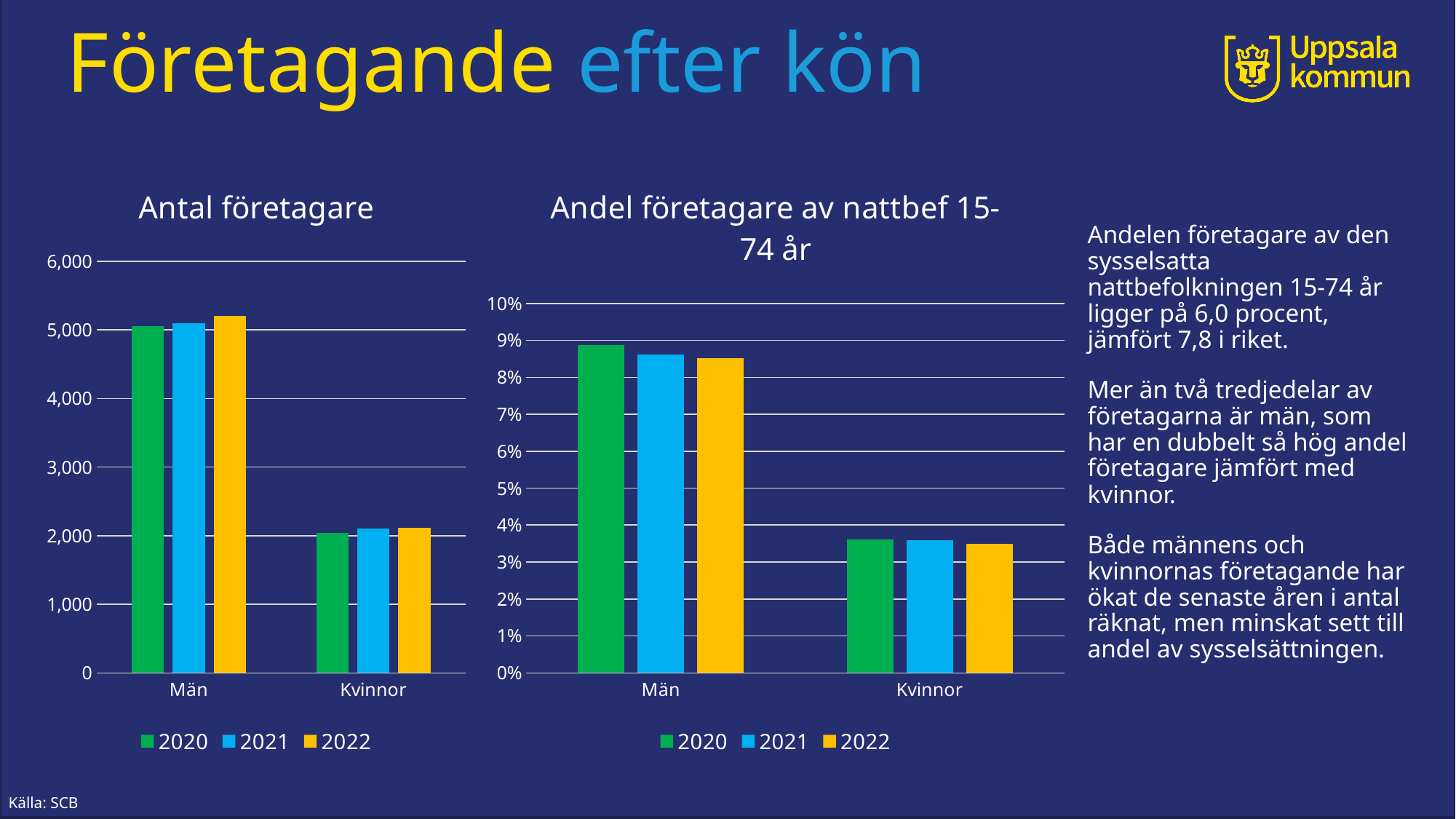
How many categories are shown on the x axis of the "Antal företagare" chart? 2 In the "Andel företagare av nattbef 15-74 år" chart, which year has the highest value for Män? 2020 What kind of chart is the "Antal företagare" chart? bar chart Which legend entry is shown in yellow in the "Antal företagare" chart? 2022 In the "Antal företagare" chart, which category has the higher value in 2021, Män or Kvinnor? Män In the "Andel företagare av nattbef 15-74 år" chart, is the value for Män in 2020 greater or less than 8%? greater In the "Antal företagare" chart, is the value for Män in 2022 greater or less than 5,000? greater How many series does the legend of the "Andel företagare av nattbef 15-74 år" chart list? 3 In the "Andel företagare av nattbef 15-74 år" chart, is the value for Kvinnor in 2022 greater or less than 4%? less In the "Andel företagare av nattbef 15-74 år" chart, do the values for Män rise or fall from 2020 to 2022? fall In the "Antal företagare" chart, do the values for Män rise or fall from 2020 to 2022? rise